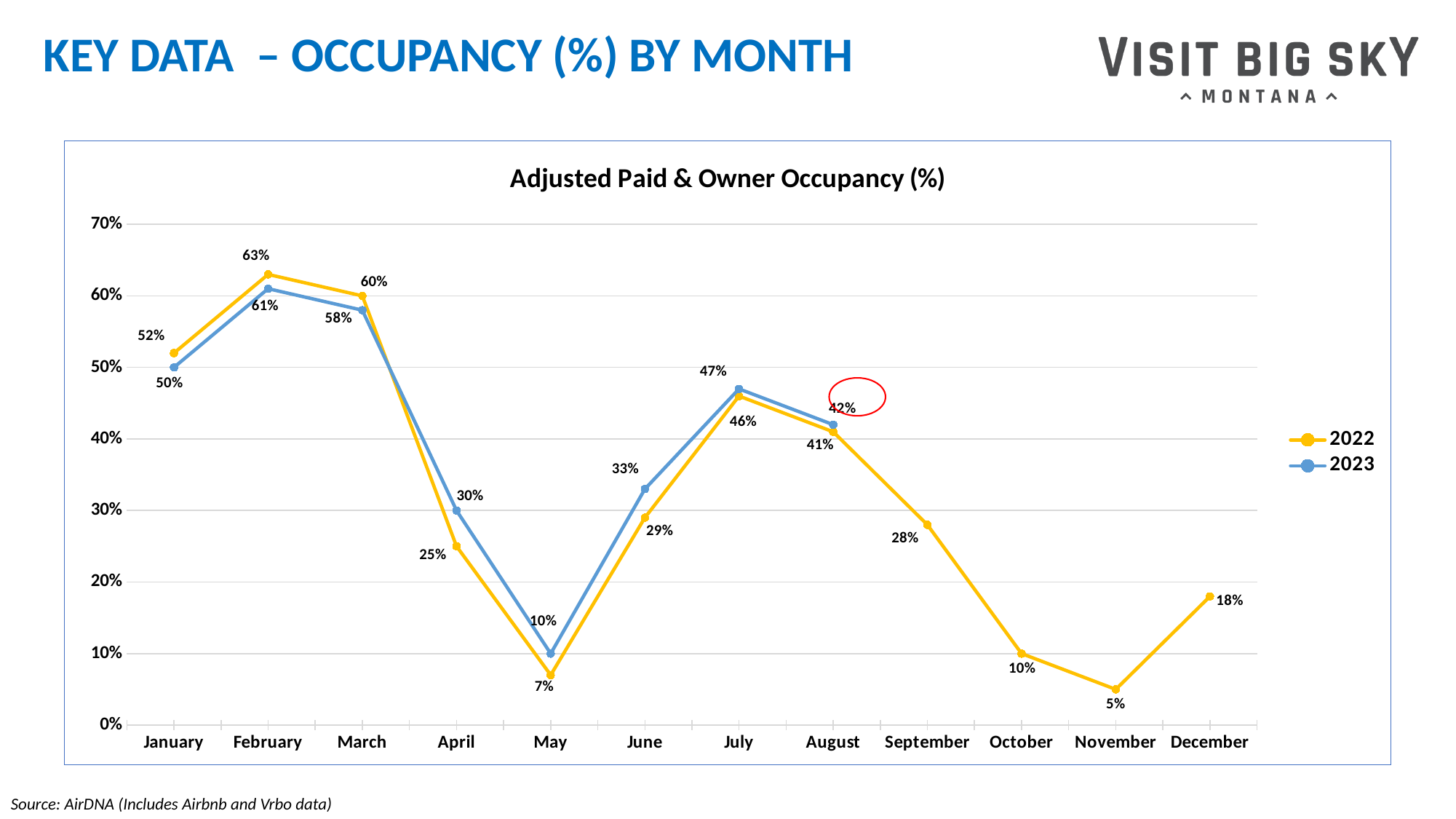
Which month has the lowest 2023 occupancy? May What is the 2022 occupancy value for November? 5% How many months have a plotted value for the 2023 series? 8 Do the 2022 occupancy values rise or fall from February to May? Fall How many series does the legend list? 2 What is the difference between the 2023 and 2022 occupancy values for June? 4% Which is larger, the 2022 or the 2023 occupancy value for January? 2022 What is the 2023 occupancy value for April? 30% What is the 2022 occupancy value for February? 63% Which month has the highest 2022 occupancy? February What kind of chart is shown on the slide? Line chart What is the title of the chart? Adjusted Paid & Owner Occupancy (%)